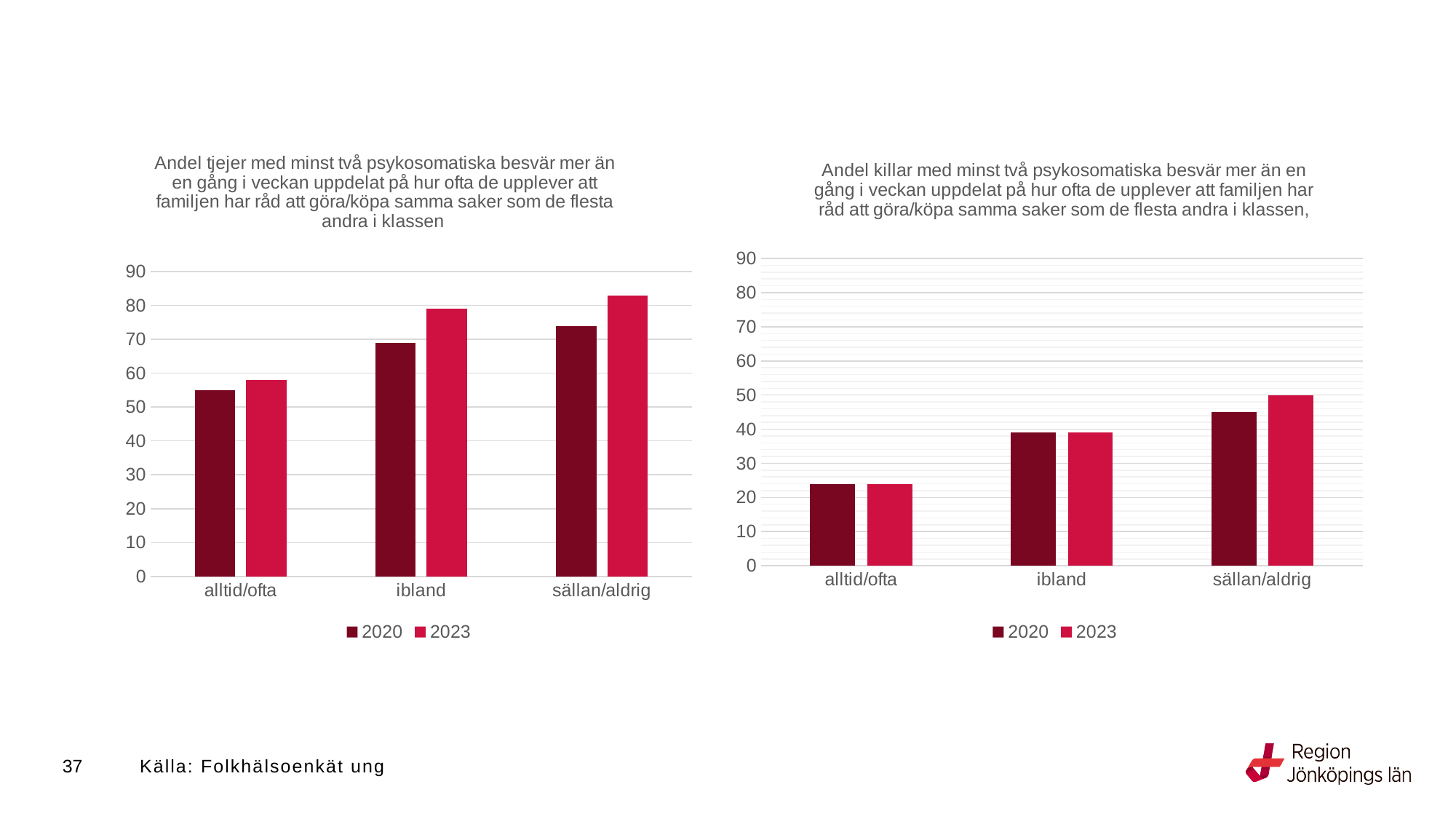
What are the two legend entries of the left chart, 'Andel tjejer med minst två psykosomatiska besvär'? 2020 and 2023 In the left chart, 'Andel tjejer med minst två psykosomatiska besvär', which is larger for ibland: the 2020 value or the 2023 value? 2023 In the left chart, 'Andel tjejer med minst två psykosomatiska besvär', is the 2023 value for ibland greater or less than 70? greater How many categories are shown on the x axis of the left chart, 'Andel tjejer med minst två psykosomatiska besvär'? 3 In the left chart, 'Andel tjejer med minst två psykosomatiska besvär', which category has the highest 2023 value? sällan/aldrig In the right chart, 'Andel killar med minst två psykosomatiska besvär', is the 2023 value for ibland greater or less than 30? greater In the left chart, 'Andel tjejer med minst två psykosomatiska besvär', is the 2020 value for sällan/aldrig greater or less than 70? greater In the right chart, 'Andel killar med minst två psykosomatiska besvär', which category has the lowest 2020 value? alltid/ofta In the right chart, 'Andel killar med minst två psykosomatiska besvär', do the 2023 values rise or fall from alltid/ofta to sällan/aldrig? rise How many series does the legend of the right chart, 'Andel killar med minst två psykosomatiska besvär', list? 2 What kind of chart is the left chart, 'Andel tjejer med minst två psykosomatiska besvär'? bar chart